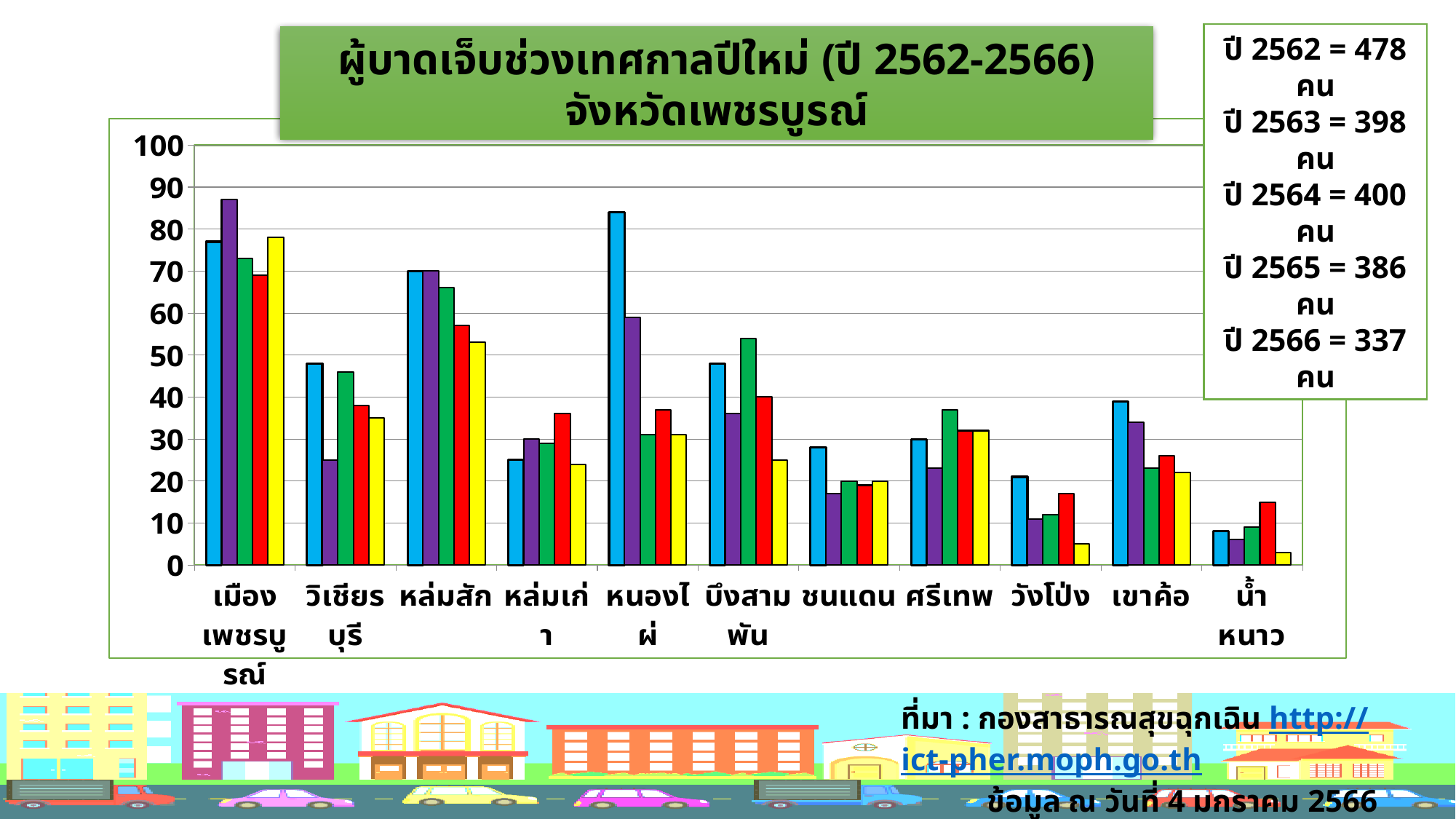
According to the text box on the slide, how many injured people were recorded in ปี 2562? 478 คน Is the value of the blue bar for หนองไผ่ greater or less than 80? greater Is the value of the yellow bar for น้ำหนาว greater or less than 10? less What type of chart is shown on the slide? bar chart Which is larger: the blue bar for หนองไผ่ or the blue bar for บึงสามพัน? หนองไผ่ Is the value of the green bar for บึงสามพัน greater or less than 50? greater Which is larger: the green bar for บึงสามพัน or the green bar for ชนแดน? บึงสามพัน How many bars are shown for each district in the chart? 5 Which district has the lowest bars overall in the chart? น้ำหนาว How many districts (categories) are shown along the x axis of the chart? 11